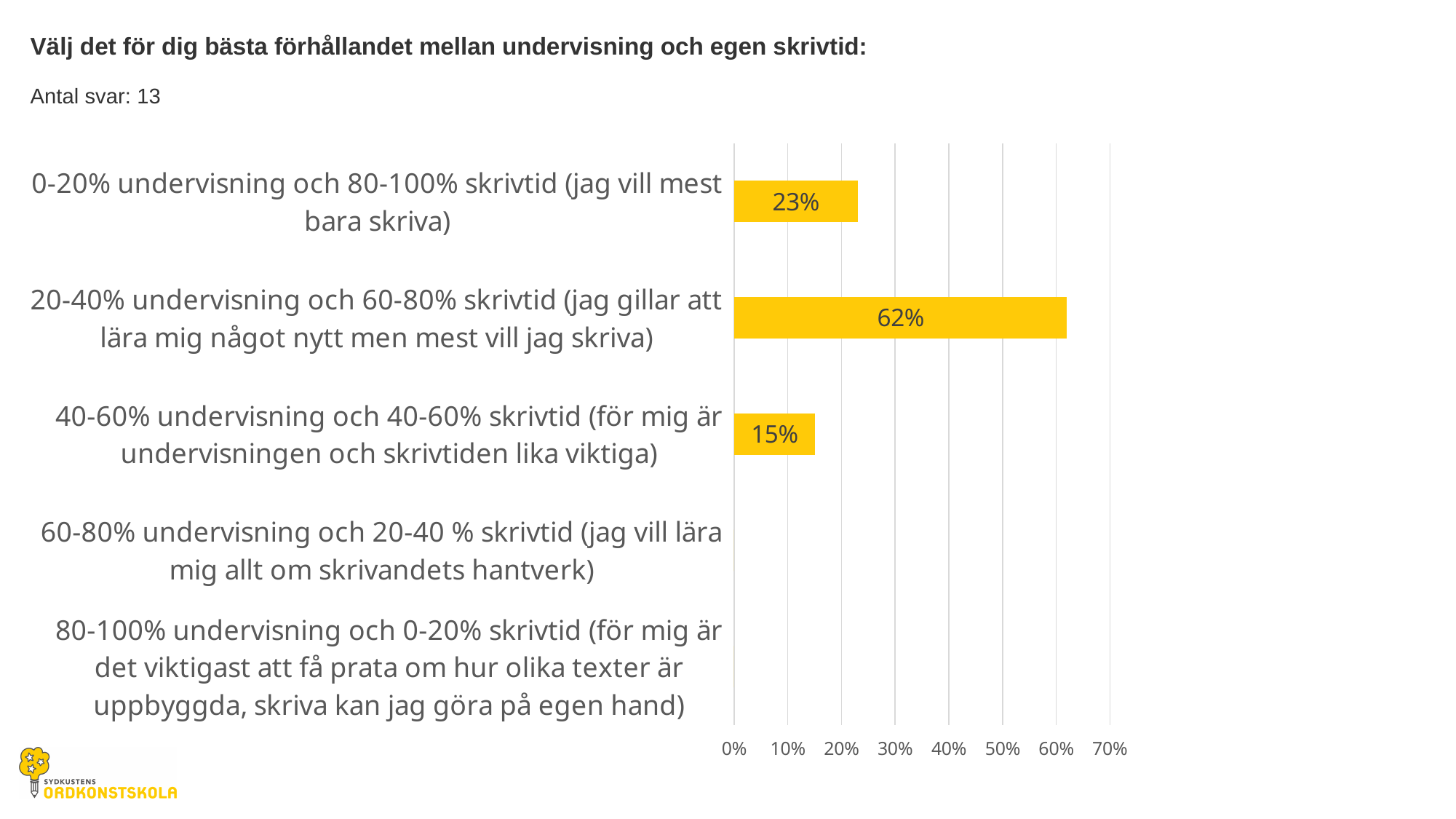
What percentage of respondents chose "20-40% undervisning och 60-80% skrivtid"? 62% What kind of chart is shown on the slide? Bar chart Is the value for "20-40% undervisning och 60-80% skrivtid" greater or less than 50%? greater What is the difference in percentage points between the "0-20% undervisning" option and the "40-60% undervisning" option? 8% What percentage of respondents chose "40-60% undervisning och 40-60% skrivtid"? 15% Which option has a larger share: "0-20% undervisning och 80-100% skrivtid" or "40-60% undervisning och 40-60% skrivtid"? 0-20% undervisning och 80-100% skrivtid How many responses (Antal svar) does the slide report? 13 Is the value for "40-60% undervisning och 40-60% skrivtid" greater or less than 20%? less Which option received the highest share of responses? 20-40% undervisning och 60-80% skrivtid (jag gillar att lära mig något nytt men mest vill jag skriva) What percentage of respondents chose "0-20% undervisning och 80-100% skrivtid"? 23% What is the difference in percentage points between the "20-40% undervisning" option and the "0-20% undervisning" option? 39% How many answer options (categories) are listed on the chart? 5